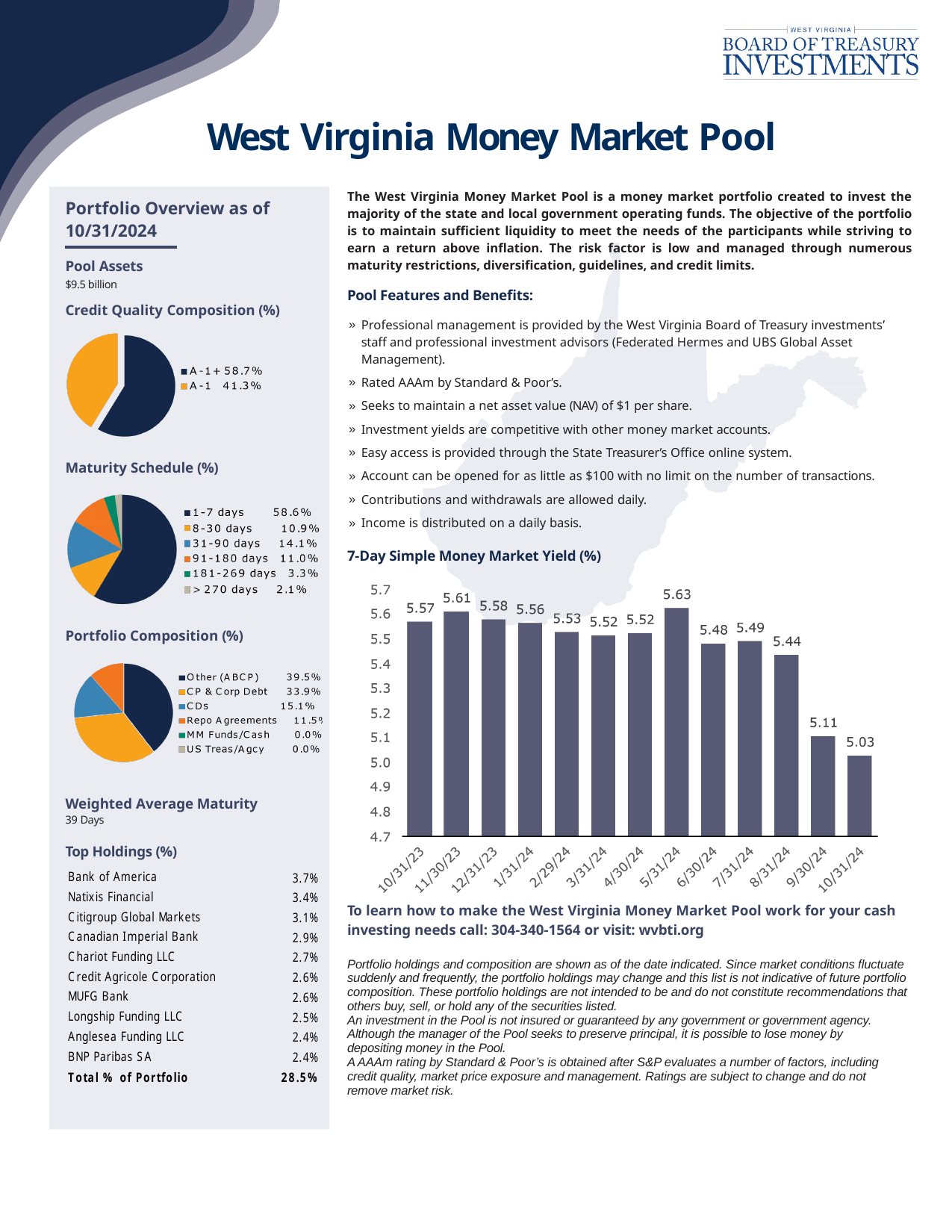
In the 7-Day Simple Money Market Yield (%) chart, do the values generally rise or fall from 5/31/24 to 10/31/24? Fall How many bars are plotted in the 7-Day Simple Money Market Yield (%) chart? 13 In the 7-Day Simple Money Market Yield (%) chart, which date has the lowest yield? 10/31/24 In the 7-Day Simple Money Market Yield (%) chart, which is larger, the value for 11/30/23 or the value for 12/31/23? 11/30/23 In the 7-Day Simple Money Market Yield (%) chart, which date has the highest yield? 5/31/24 In the 7-Day Simple Money Market Yield (%) chart, what is the difference between the values for 9/30/24 and 10/31/24? 0.08 In the 7-Day Simple Money Market Yield (%) chart, what is the value for 5/31/24? 5.63 In the Maturity Schedule (%) pie chart, what is the value for 31-90 days? 14.1% In the Credit Quality Composition (%) pie chart, what share is A-1+? 58.7% What kind of chart is the 7-Day Simple Money Market Yield (%) chart? Bar chart In the 7-Day Simple Money Market Yield (%) chart, what is the value for 10/31/24? 5.03 In the Portfolio Composition (%) pie chart, which category has the largest share? Other (ABCP)